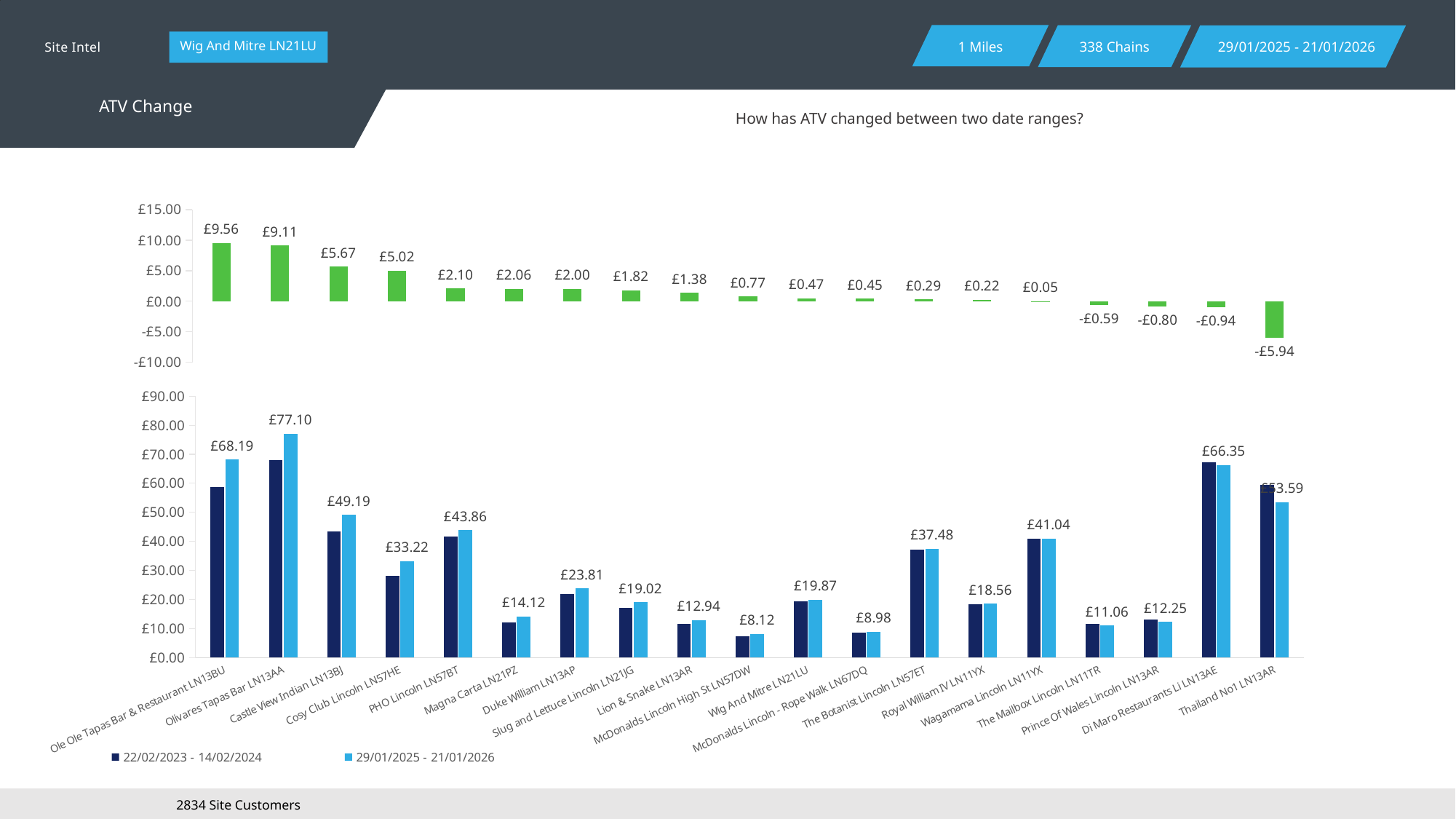
In the bottom chart, is the 22/02/2023 - 14/02/2024 value for Olivares Tapas Bar LN13AA greater or less than £60.00? greater In the bottom chart, which category has the highest value for 29/01/2025 - 21/01/2026? Olivares Tapas Bar LN13AA How many series does the legend of the bottom chart list? 2 In the top chart, which category has the lowest ATV change? Thailand No1 LN13AR In the top chart, what is the difference between the ATV change for Ole Ole Tapas Bar & Restaurant LN13BU and Olivares Tapas Bar LN13AA? £0.45 In the bottom chart, which is larger for 29/01/2025 - 21/01/2026: Di Maro Restaurants Li LN13AE or Thailand No1 LN13AR? Di Maro Restaurants Li LN13AE What kind of chart is the bottom chart? Bar chart In the top chart, what is the ATV change for Ole Ole Tapas Bar & Restaurant LN13BU? £9.56 In the bottom chart, what is the value for Wagamama Lincoln LN11YX in the 29/01/2025 - 21/01/2026 period? £41.04 How many categories are shown on the x axis of the bottom chart? 19 In the top chart, do the ATV change values rise or fall from left to right along the x axis? Fall In the top chart, what is the ATV change for Thailand No1 LN13AR? -£5.94